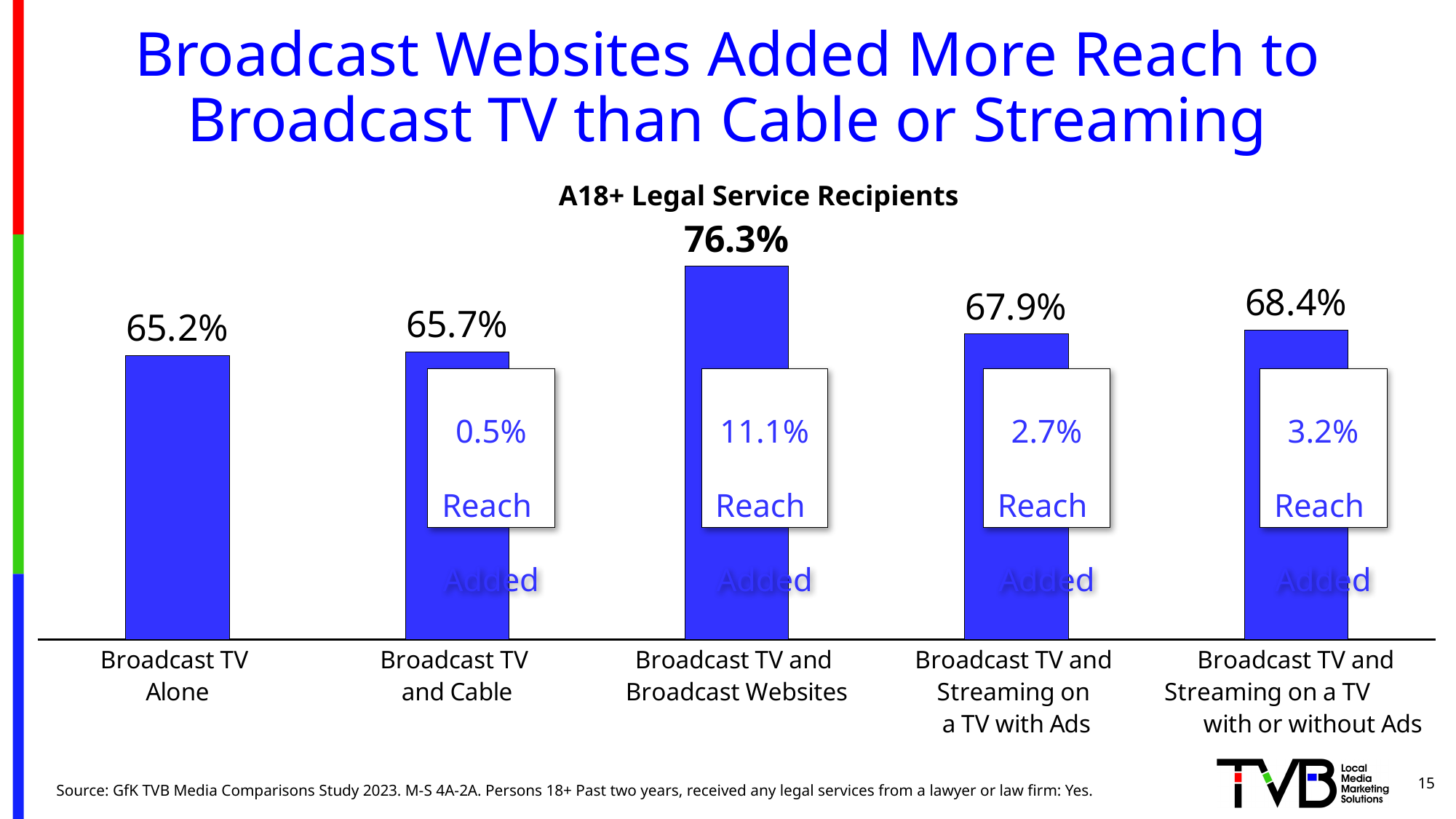
What is the difference between Broadcast TV and Broadcast Websites and Broadcast TV Alone? 11.1% Which is larger: Broadcast TV and Streaming on a TV with Ads or Broadcast TV and Cable? Broadcast TV and Streaming on a TV with Ads What kind of chart is shown on the slide? Bar chart What is the subtitle of the chart? A18+ Legal Service Recipients How many categories are shown in the chart? 5 What added reach is shown for Broadcast TV and Streaming on a TV with or without Ads? 3.2% What is the value for Broadcast TV and Cable? 65.7% Which category has the highest value? Broadcast TV and Broadcast Websites What is the value for Broadcast TV and Streaming on a TV with Ads? 67.9% What is the value for Broadcast TV and Broadcast Websites? 76.3% Which category has the lowest value? Broadcast TV Alone What is the value for Broadcast TV Alone? 65.2%